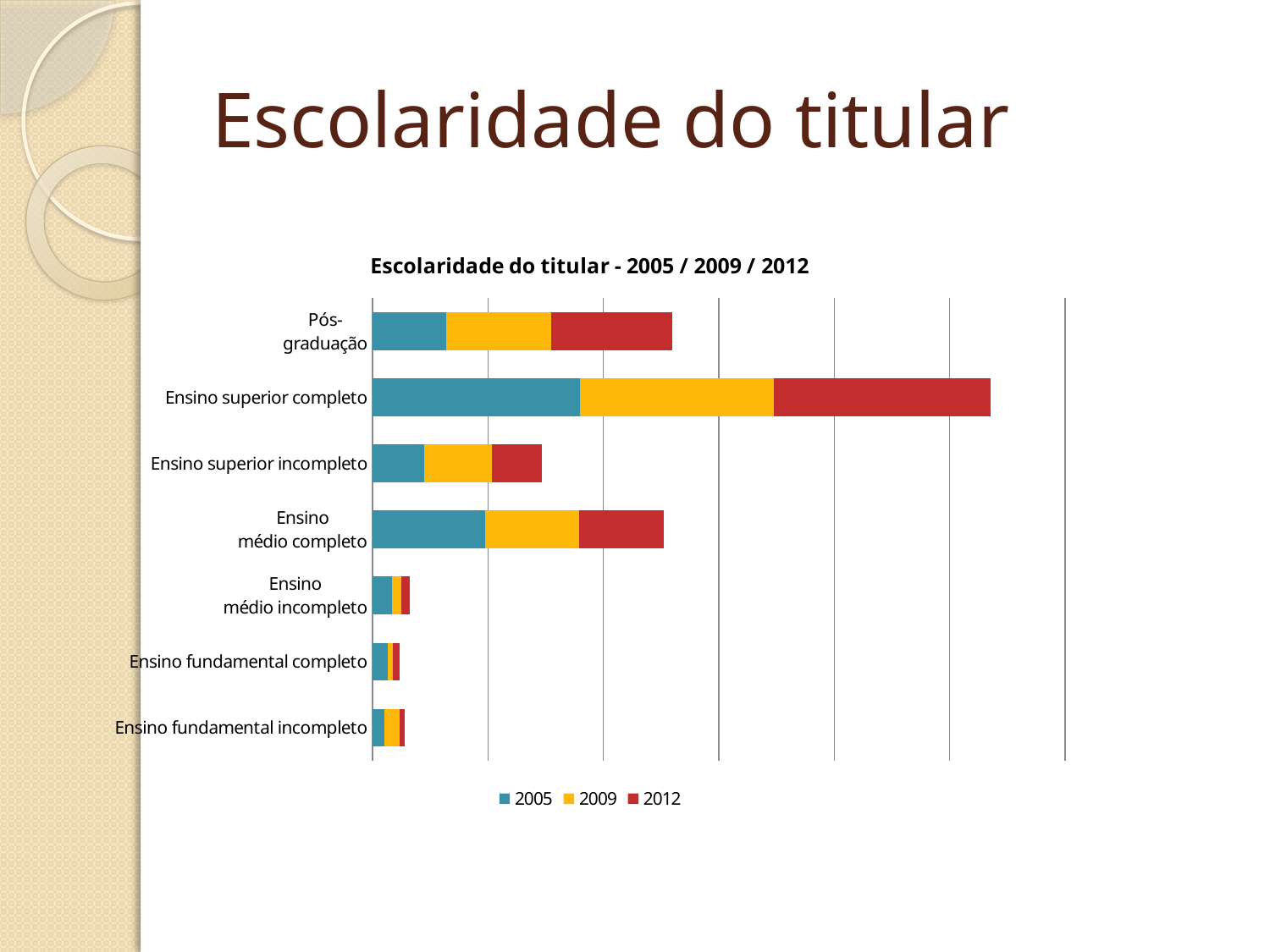
Which category has the largest 2012 segment? Ensino superior completo How many education-level categories are shown on the chart? 7 Which series is shown in yellow in the legend? 2009 Which has the longer total bar, Ensino médio completo or Ensino médio incompleto? Ensino médio completo Which has the larger 2005 segment, Pós-graduação or Ensino superior incompleto? Pós-graduação How many series does the legend list? 3 What kind of chart is shown on the slide? Bar chart Which category has the longest stacked bar overall? Ensino superior completo Which has the longer total bar, Ensino superior completo or Ensino médio completo? Ensino superior completo Which category has the largest 2005 segment? Ensino superior completo What is the title of the chart? Escolaridade do titular - 2005 / 2009 / 2012